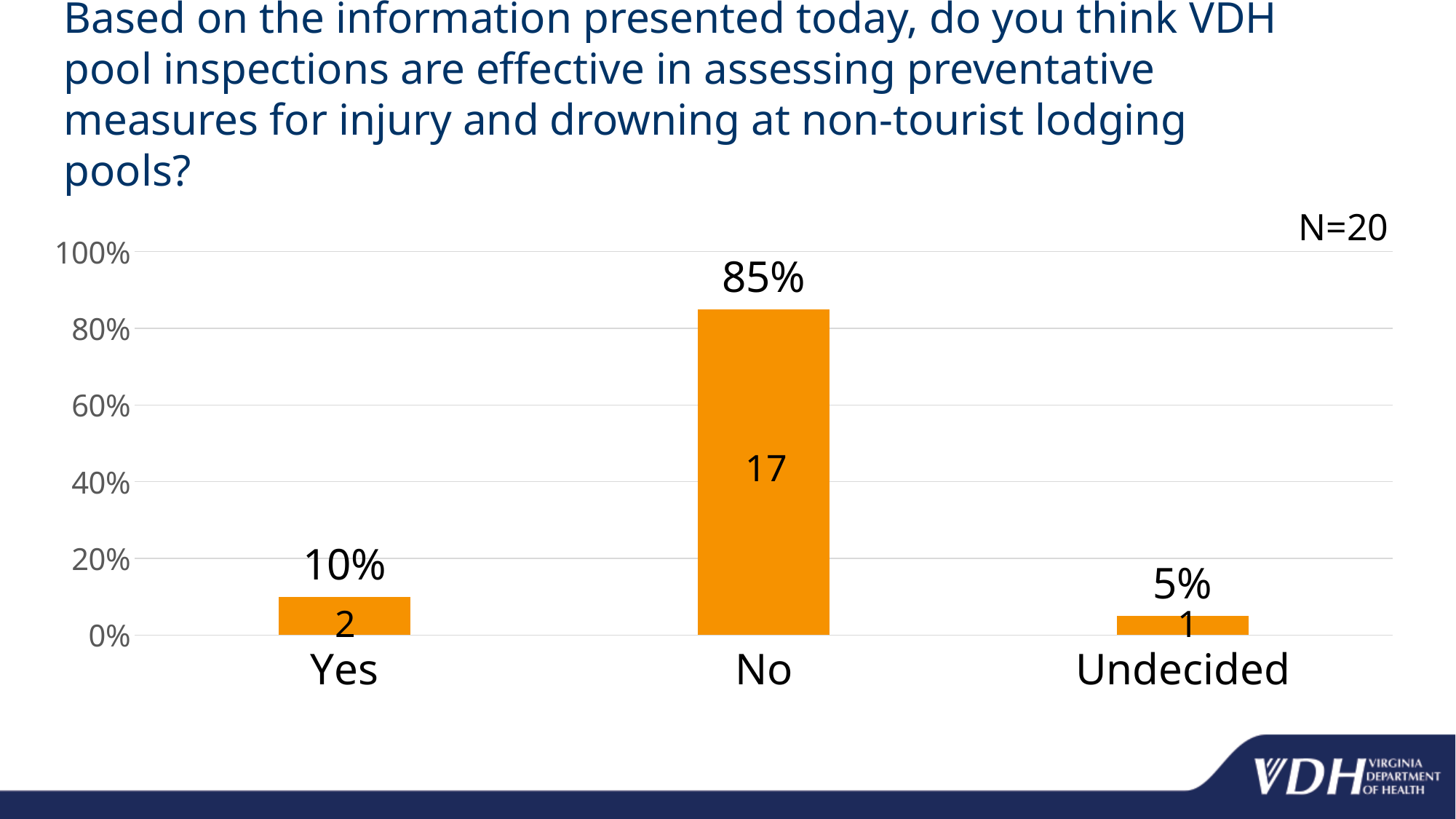
How many response categories are shown on the chart? 3 Which is larger, the value for "Yes" or the value for "Undecided"? Yes What percentage of respondents answered "No"? 85% Which response category has the highest value? No What percentage of respondents answered "Yes"? 10% How many respondents answered "Yes"? 2 What is the difference in percentage points between the "No" and "Yes" responses? 75 How many respondents answered "No"? 17 What percentage of respondents were "Undecided"? 5% Which response category has the lowest value? Undecided What is the total number of respondents (N) shown on the slide? 20 What kind of chart is shown on the slide? Bar chart